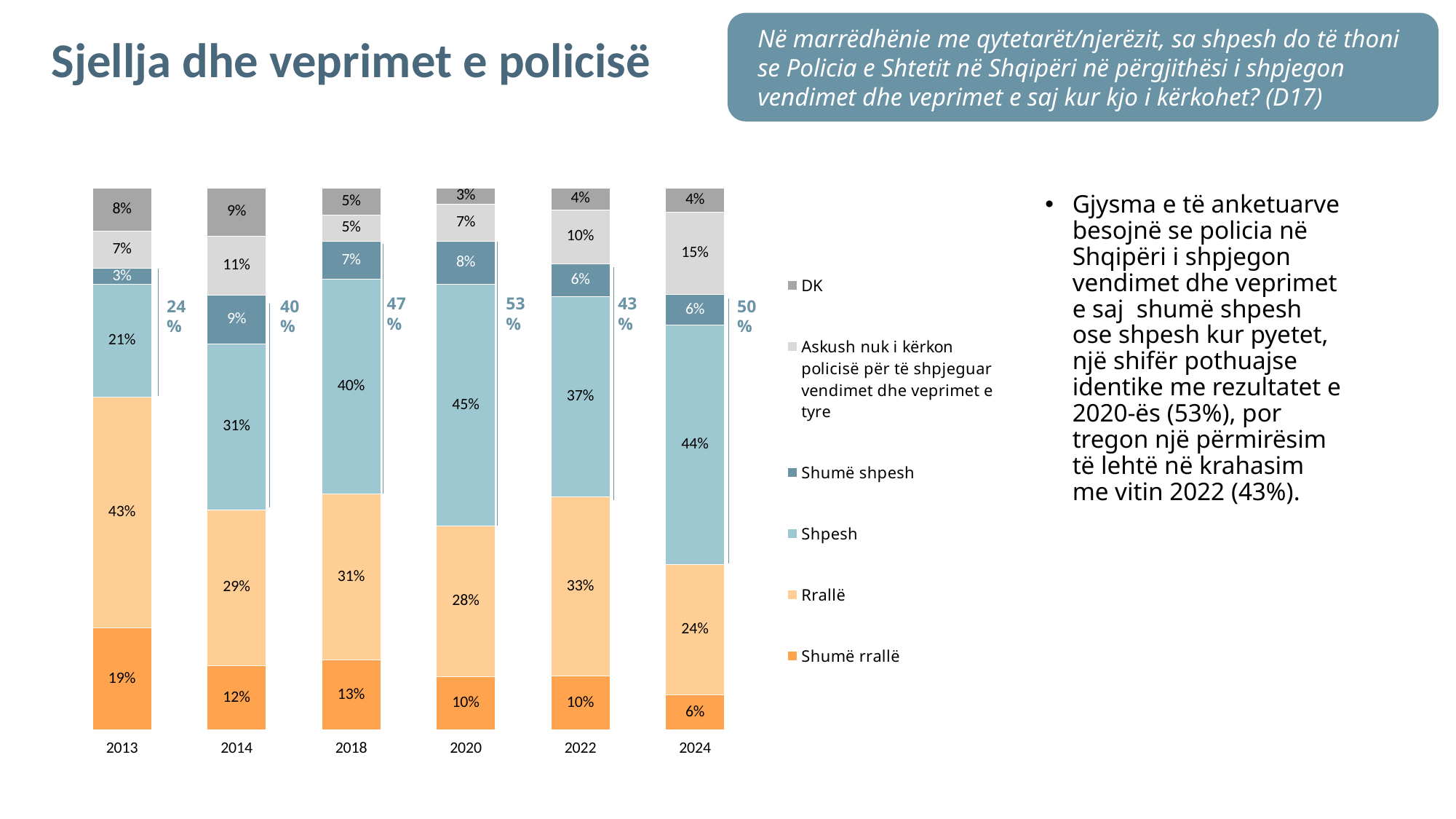
Does the 'Shumë rrallë' value rise or fall from 2013 to 2024? Fall What combined percentage is marked beside the 2020 bar for 'Shumë shpesh' and 'Shpesh'? 53% How many years (categories) are shown on the x axis of the chart? 6 Which is larger: the 'Shumë shpesh' value in 2014 or in 2018? 2014 What kind of chart is shown on the slide? Stacked bar chart What is the value for 'Shpesh' in 2024? 44% In which year is the 'Rrallë' value highest? 2013 What is the value for 'Askush nuk i kërkon policisë për të shpjeguar vendimet dhe veprimet e tyre' in 2022? 10% How many series does the chart legend list? 6 In which year is the 'Shumë rrallë' value lowest? 2024 What is the value for 'Shumë rrallë' in 2013? 19% What is the difference between the 'Shpesh' value in 2020 and in 2013? 24%